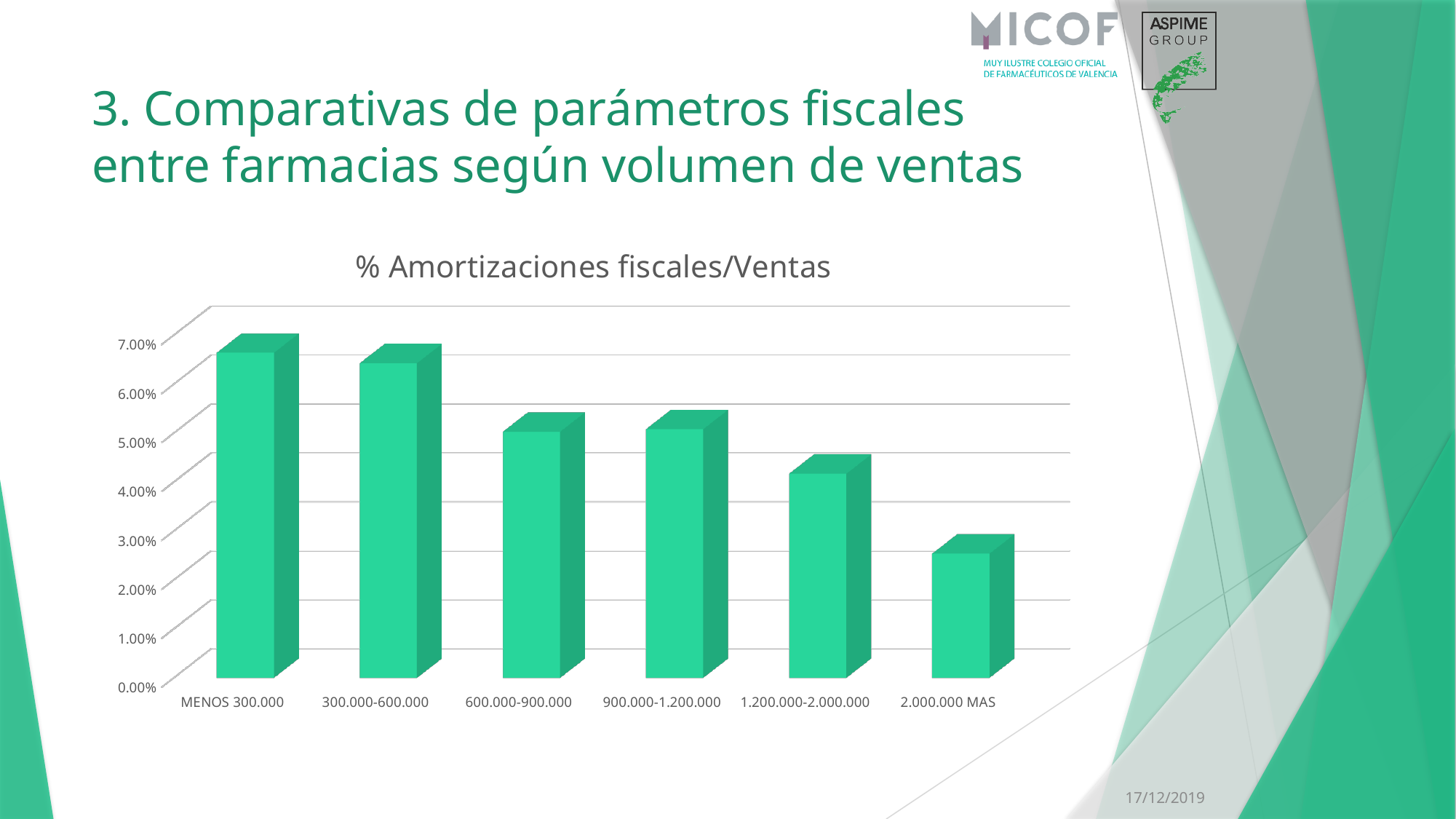
Do the values generally rise or fall as sales volume increases along the x axis? fall Which category has the highest % Amortizaciones fiscales/Ventas? MENOS 300.000 Is the value for 2.000.000 MAS greater or less than 3.00%? less Which category has the lowest % Amortizaciones fiscales/Ventas? 2.000.000 MAS Which is larger, the value for MENOS 300.000 or the value for 600.000-900.000? MENOS 300.000 Is the value for MENOS 300.000 greater or less than 6.00%? greater What kind of chart is shown on the slide? bar chart Which is larger, the value for 1.200.000-2.000.000 or the value for 2.000.000 MAS? 1.200.000-2.000.000 How many sales-volume categories are plotted on the x axis? 6 What is the title of the chart? % Amortizaciones fiscales/Ventas Is the value for 600.000-900.000 greater or less than 6.00%? less